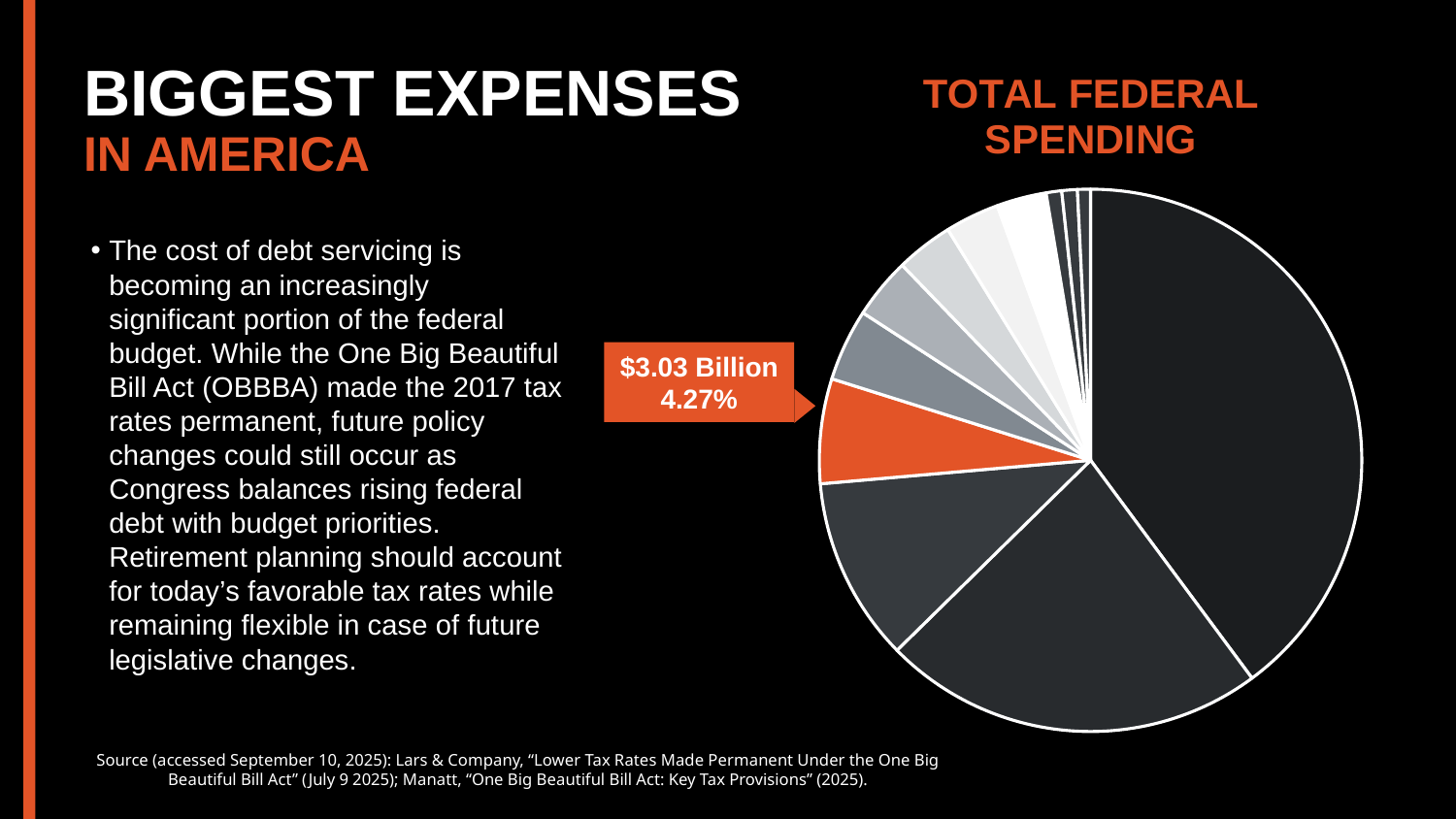
What colour is the slice that is called out with a data label in the pie chart? orange Is the highlighted orange slice larger or smaller than the largest dark slice of the pie? smaller What share of total federal spending does the highlighted orange slice represent? 4.27% What kind of chart is shown under the heading "TOTAL FEDERAL SPENDING"? pie chart What is the title of the chart on the slide? TOTAL FEDERAL SPENDING What dollar value is labeled on the highlighted orange slice of the pie chart? $3.03 Billion Is the share of the highlighted orange slice greater or less than 5%? less